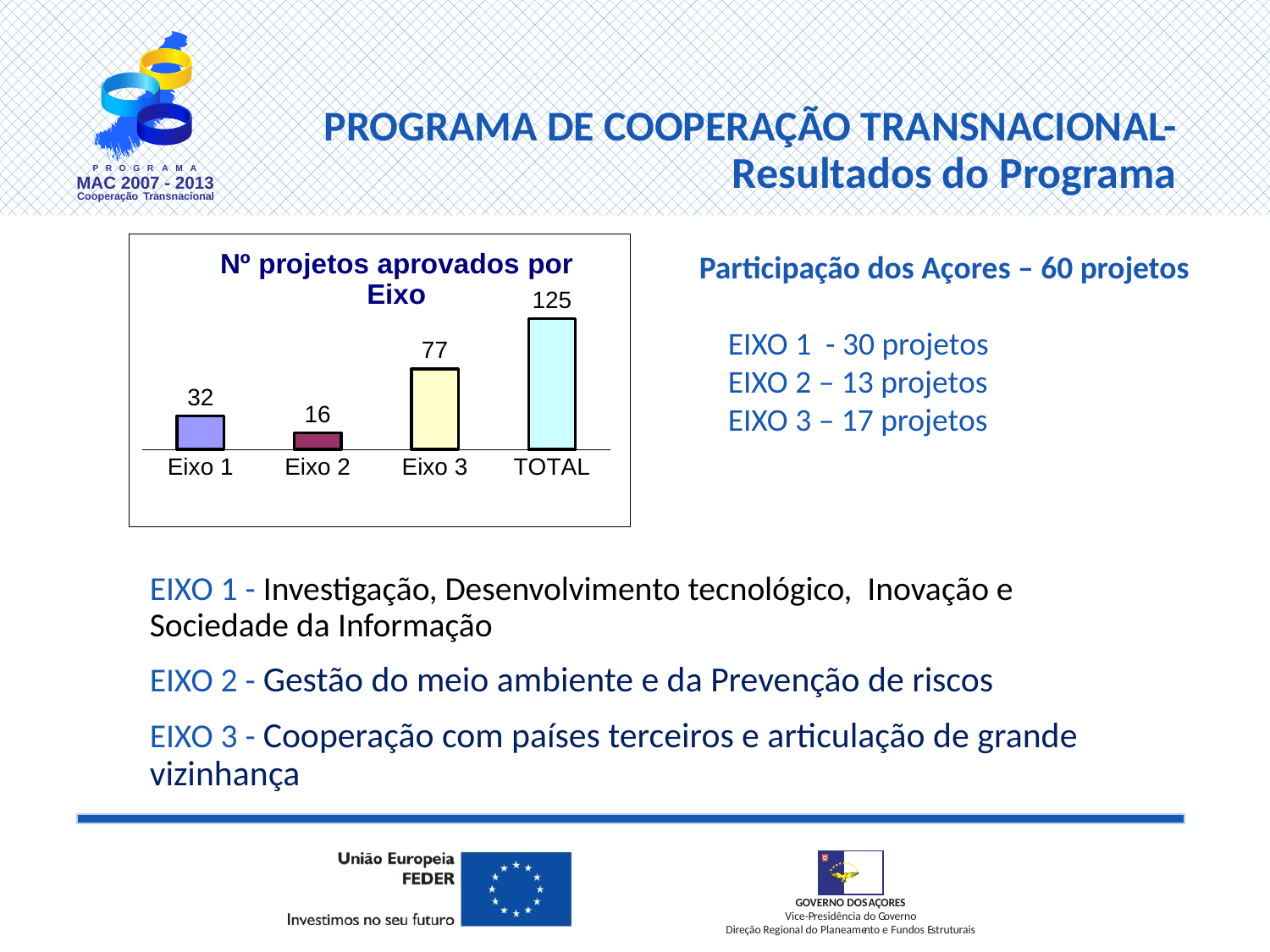
What is the value for Eixo 2 in the chart? 16 What is the value for Eixo 1 in the chart? 32 What is the difference between the values for Eixo 1 and Eixo 2? 16 Which category has the highest value in the chart? TOTAL What is the title of the chart? Nº projetos aprovados por Eixo Which is larger, the value for Eixo 1 or the value for Eixo 3? Eixo 3 What is the value for Eixo 3 in the chart? 77 What is the value for TOTAL in the chart? 125 How many categories are shown on the x axis of the chart? 4 Which category has the lowest value in the chart? Eixo 2 What is the difference between the values for Eixo 3 and Eixo 1? 45 What kind of chart is shown on the slide? Bar chart